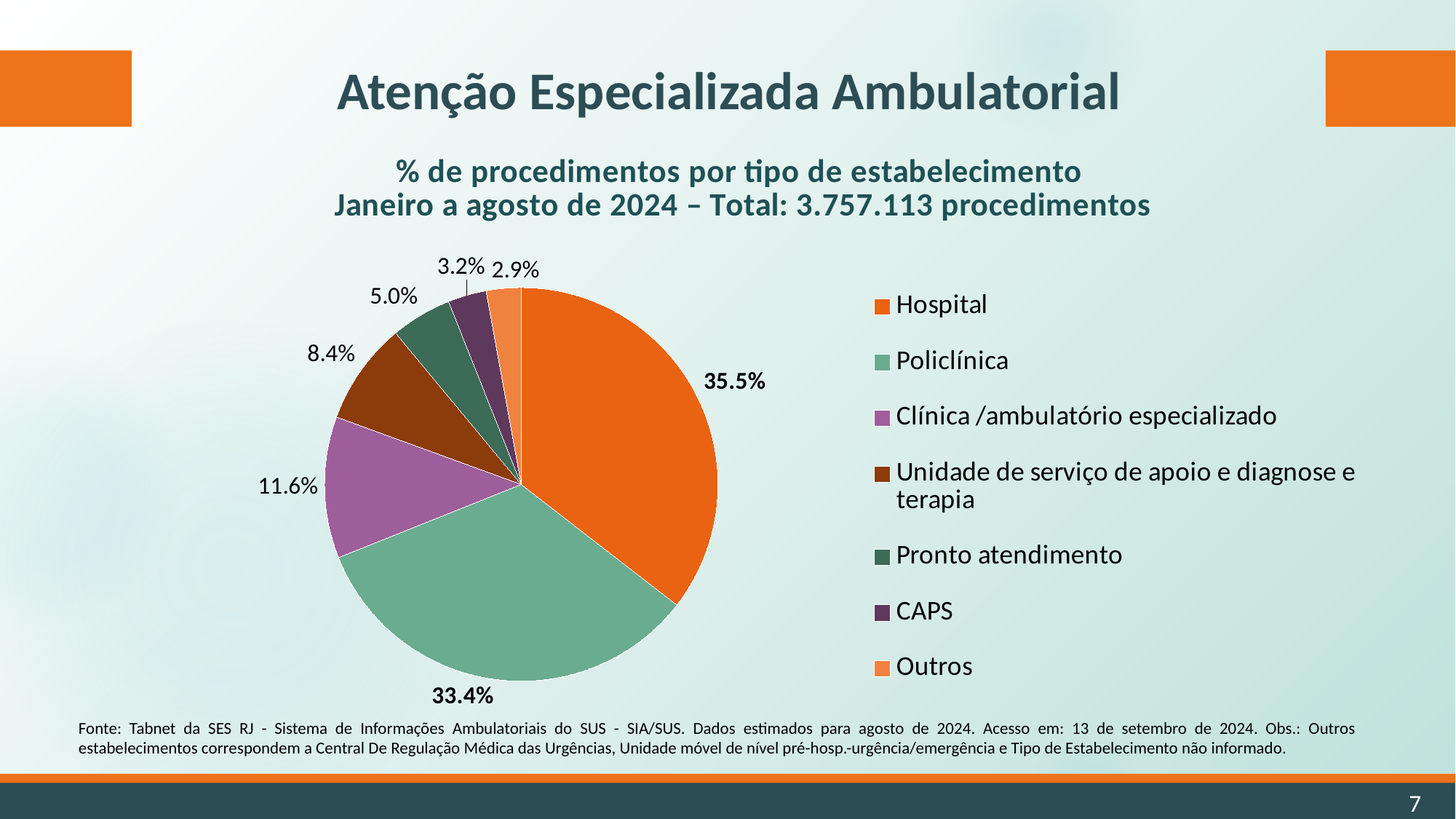
What kind of chart is shown on the slide? Pie chart What is the value shown for Clínica /ambulatório especializado? 11.6% Which type of establishment has the largest share of procedures? Hospital What is the value shown for Pronto atendimento? 5.0% How many categories does the pie chart show? 7 What is the difference in percentage points between the Hospital and Policlínica slices? 2.1 What is the value shown for CAPS? 3.2% What total number of procedures is stated in the chart title? 3.757.113 What percentage of procedures does the Hospital slice represent? 35.5% What percentage of procedures does the Policlínica slice represent? 33.4% Which is larger, the share for Unidade de serviço de apoio e diagnose e terapia or the share for Pronto atendimento? Unidade de serviço de apoio e diagnose e terapia Which type of establishment has the smallest share of procedures? Outros